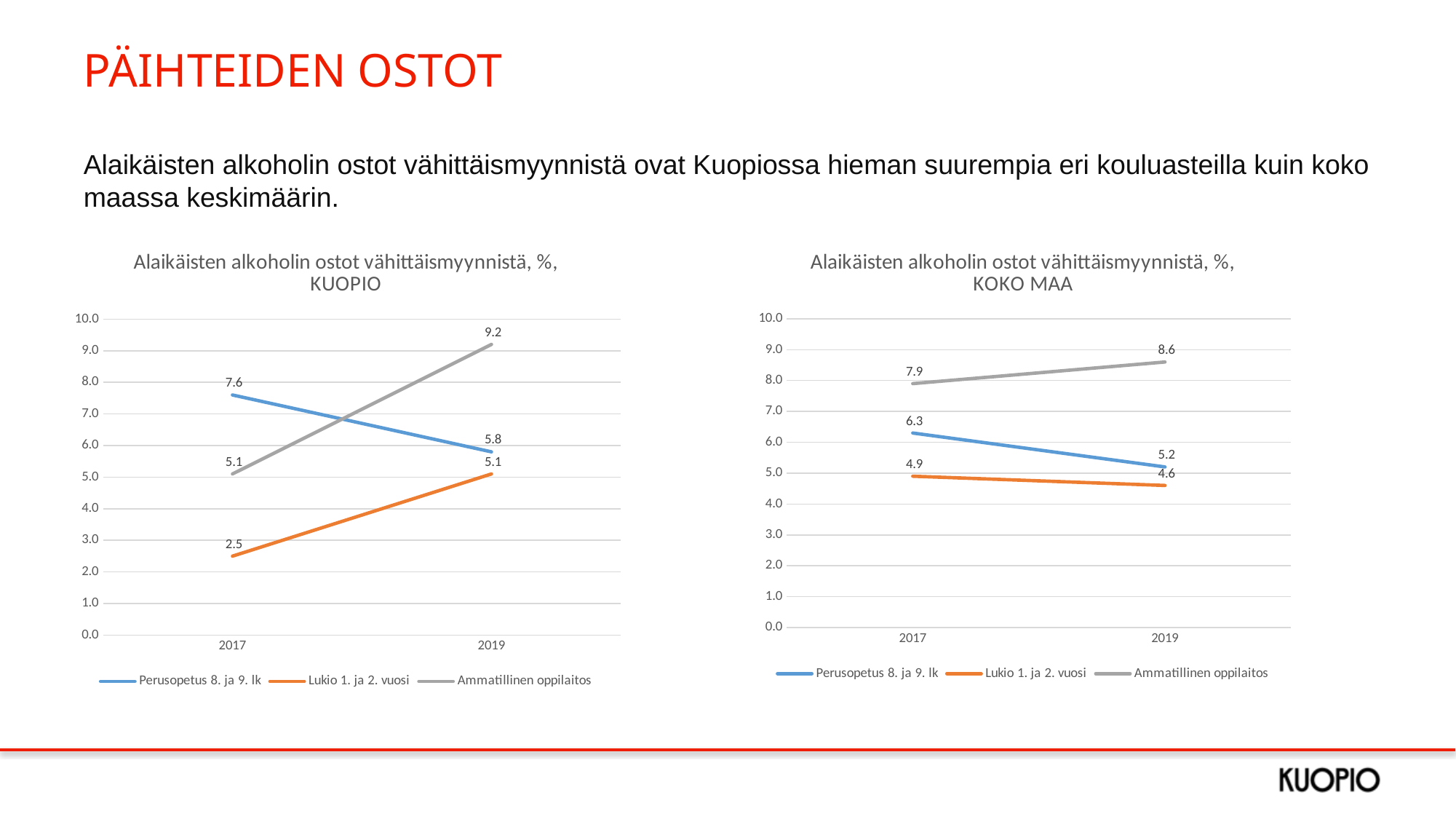
In the KUOPIO chart, what is the value for Lukio 1. ja 2. vuosi in 2017? 2.5 In the KOKO MAA chart, what is the value for Ammatillinen oppilaitos in 2017? 7.9 In the KUOPIO chart, which series has the highest value in 2017? Perusopetus 8. ja 9. lk In the KOKO MAA chart, which series has the lowest value in 2019? Lukio 1. ja 2. vuosi What kind of chart is the KUOPIO chart? line chart Which is larger: the 2019 Ammatillinen oppilaitos value in the KUOPIO chart or in the KOKO MAA chart? KUOPIO How many series does the legend of the KOKO MAA chart list? 3 In the KUOPIO chart, does the Perusopetus 8. ja 9. lk series rise or fall from 2017 to 2019? fall In the KUOPIO chart, what is the difference between the Ammatillinen oppilaitos values in 2019 and 2017? 4.1 In the KOKO MAA chart, what is the difference between Ammatillinen oppilaitos and Perusopetus 8. ja 9. lk in 2019? 3.4 In the KOKO MAA chart, what is the value for Perusopetus 8. ja 9. lk in 2019? 5.2 In the KUOPIO chart, what is the value for Ammatillinen oppilaitos in 2019? 9.2